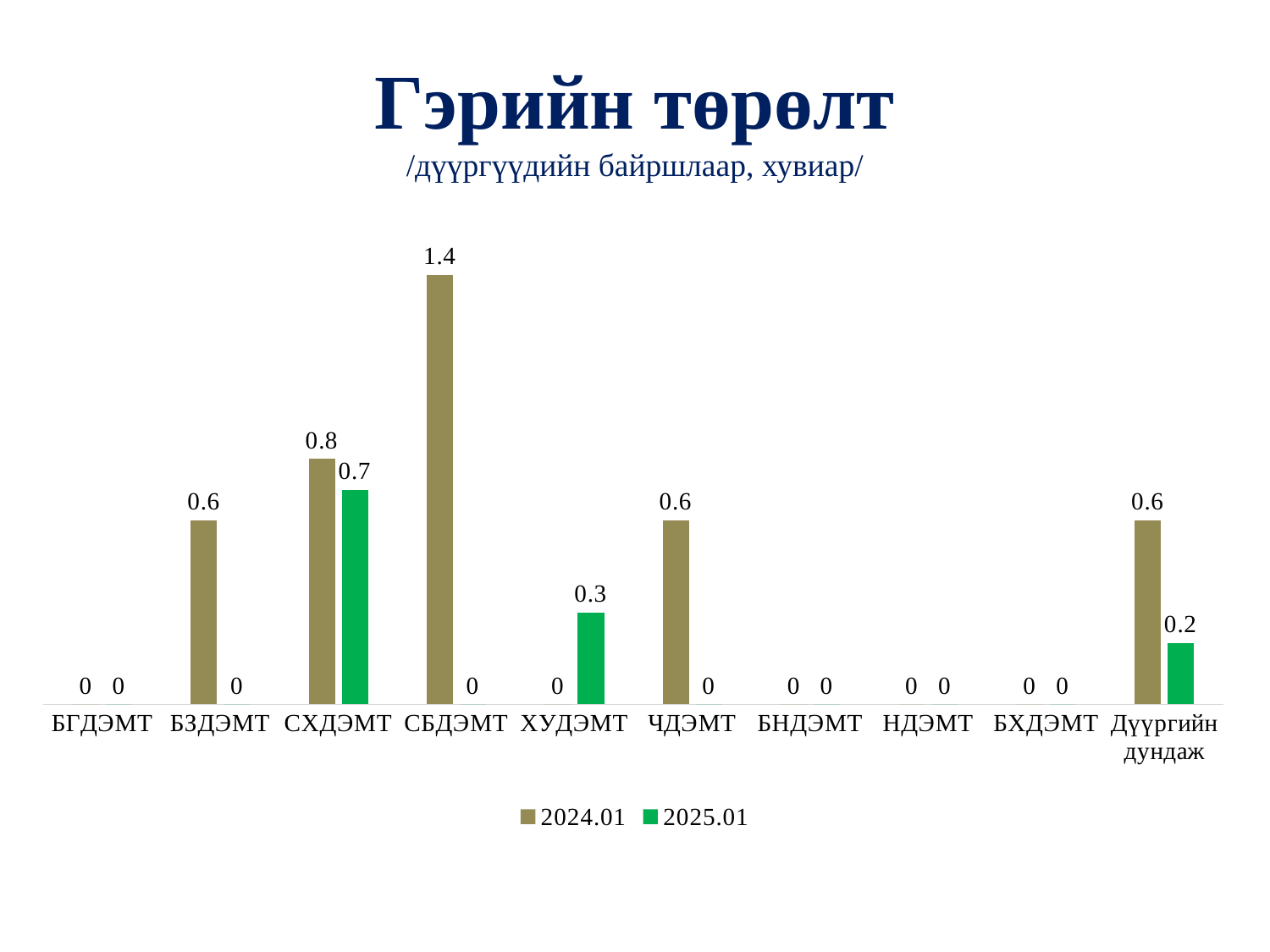
What is the value for СХДЭМТ in the 2025.01 series? 0.7 How many series does the legend list? 2 What is the 2025.01 value for Дүүргийн дундаж? 0.2 Which category has the highest value in the 2025.01 series? СХДЭМТ What is the difference between the 2024.01 and 2025.01 values for СХДЭМТ? 0.1 What kind of chart is shown on the slide? Bar chart What is the difference between the 2024.01 values for СБДЭМТ and БЗДЭМТ? 0.8 How many categories are shown on the x axis? 10 Which category has the highest value in the 2024.01 series? СБДЭМТ What is the value for СБДЭМТ in the 2024.01 series? 1.4 Which is larger for Дүүргийн дундаж: the 2024.01 value or the 2025.01 value? 2024.01 What is the value for ХУДЭМТ in the 2025.01 series? 0.3